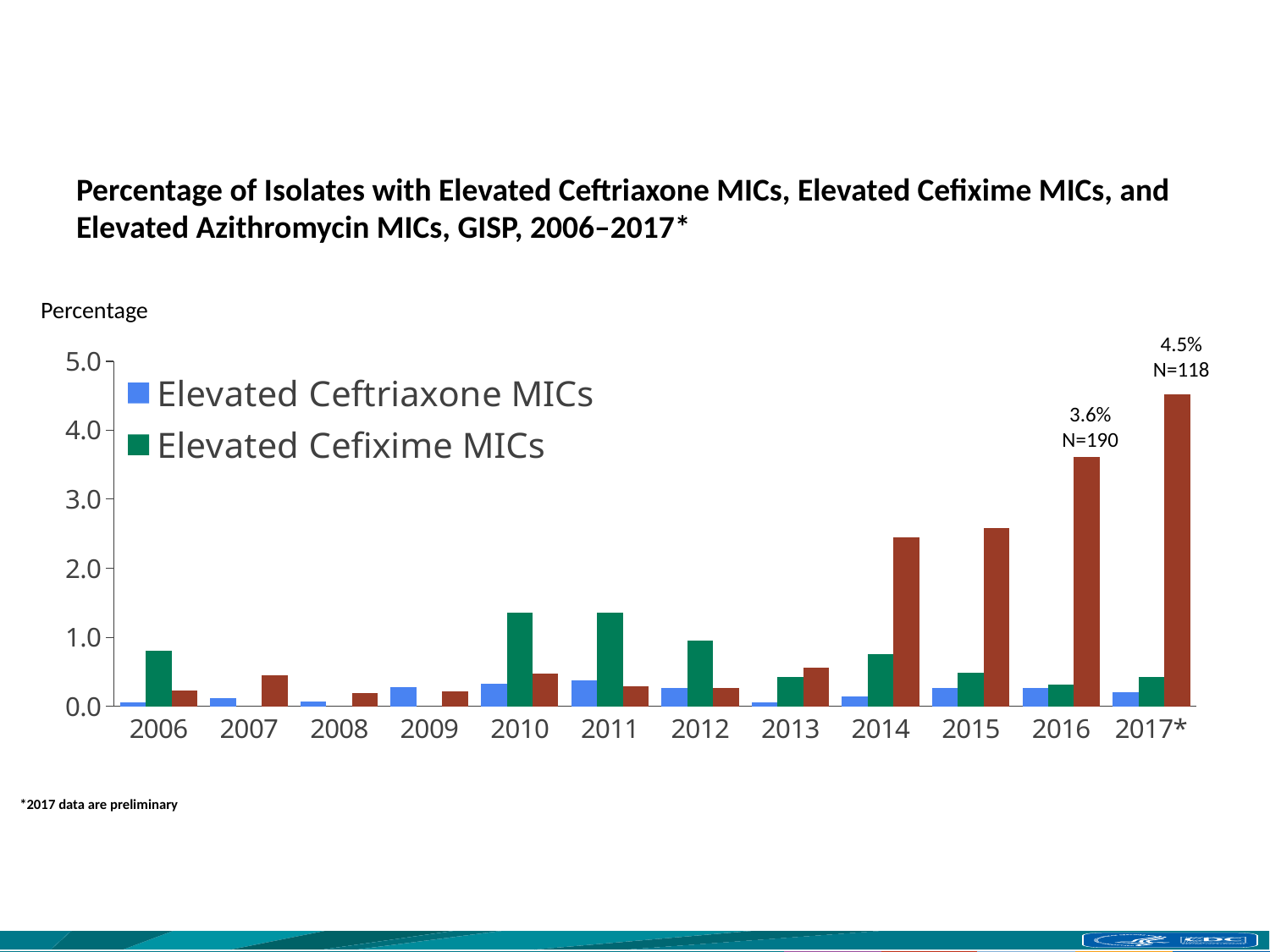
What kind of chart is shown on the slide? Bar chart How many series does the chart's legend list? 2 Which is larger, the Elevated Cefixime MICs value for 2011 or for 2012? 2011 What is the difference between the labelled percentages for 2017* (4.5%) and 2016 (3.6%)? 0.9% Which year has the tallest bar in the chart? 2017* Do the tallest (brown) bars rise or fall from 2014 to 2017*? Rise Is the tallest bar for 2014 greater or less than 2.0? greater Is the Elevated Cefixime MICs value for 2006 greater or less than 1.0? less What label is printed above the y axis of the chart? Percentage What N value is printed above the tallest bar for 2016? N=190 How many years are shown along the x axis of the chart? 12 What percentage is printed above the tallest bar for 2017*? 4.5%